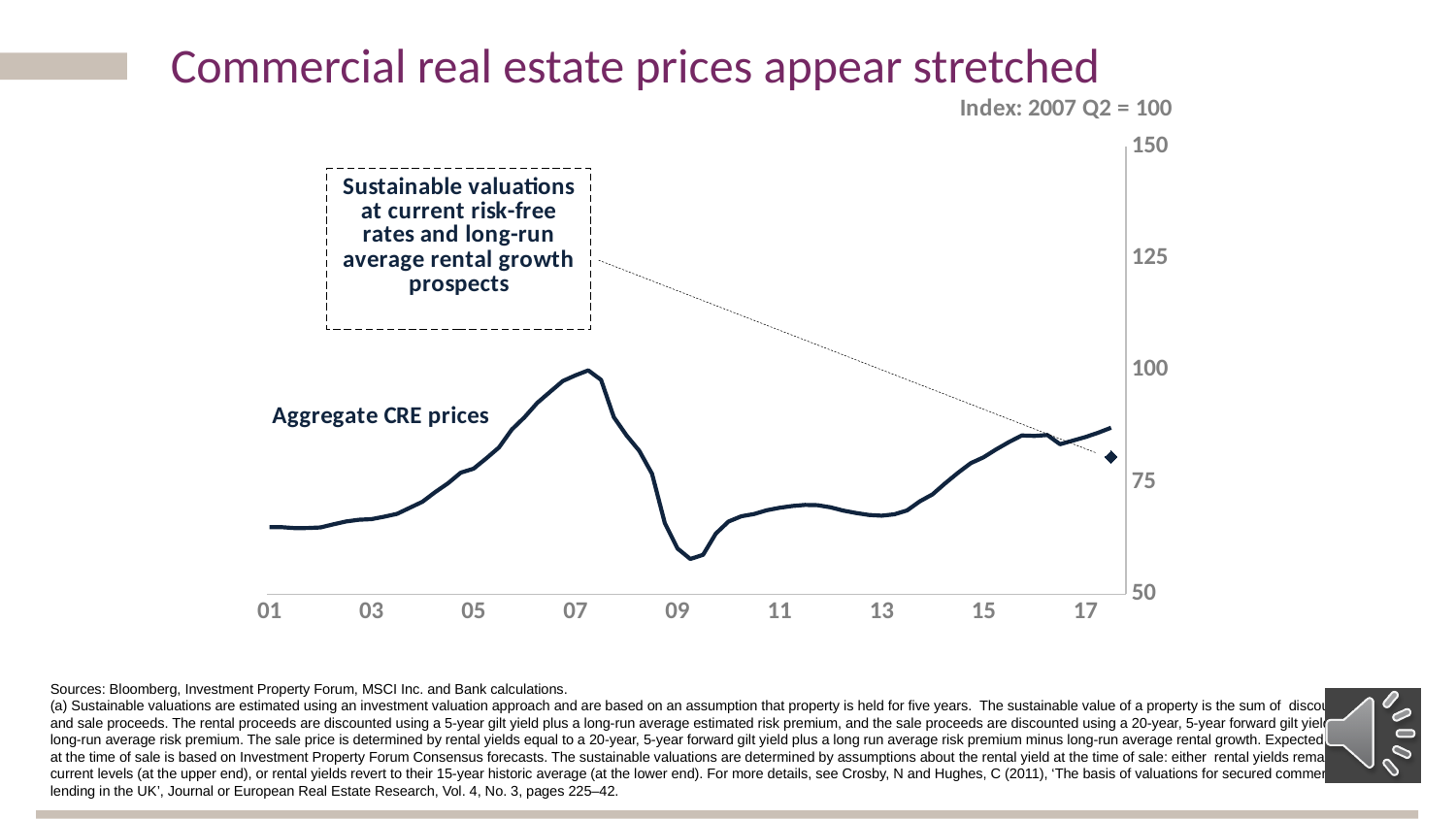
What is the title of the chart? Commercial real estate prices appear stretched Around which year does the Aggregate CRE prices line reach its lowest point? 2009 Is the value of Aggregate CRE prices in 2017 greater or less than 100? less Is the value of Aggregate CRE prices at its 2009 trough greater or less than 50? greater Is the value of Aggregate CRE prices at its 2009 trough greater or less than 75? less Do Aggregate CRE prices rise or fall between 2007 and 2009? fall Do Aggregate CRE prices rise or fall between 2001 and 2007? rise What is the index base stated above the chart? Index: 2007 Q2 = 100 What kind of chart is shown on the slide? line chart Around which year does the Aggregate CRE prices line reach its highest point? 2007